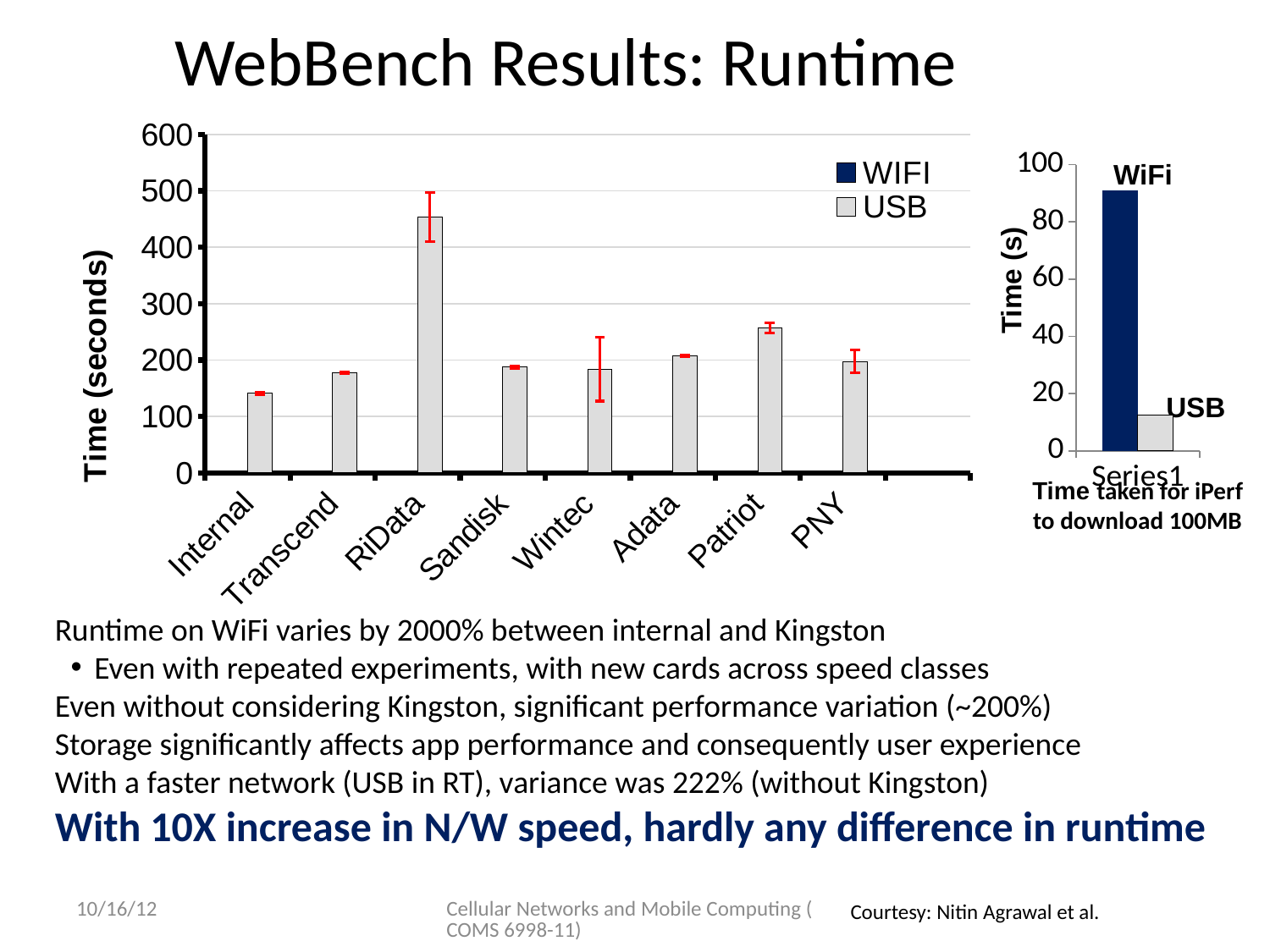
In the main WebBench runtime chart, which storage card has the highest USB runtime? RiData In the main WebBench runtime chart, is the value for Transcend greater or less than 200? less In the main WebBench runtime chart, which is larger, the value for Patriot or the value for Adata? Patriot What kind of chart is the main WebBench runtime chart? bar chart In the small chart on the right showing time taken for iPerf to download 100MB, is the value for WiFi greater or less than 80? greater In the small chart on the right showing time taken for iPerf to download 100MB, which is larger, WiFi or USB? WiFi In the main WebBench runtime chart, is the value for RiData greater or less than 400? greater How many series does the legend of the main WebBench runtime chart list? 2 In the main WebBench runtime chart, which category has the lowest runtime? Internal How many storage card categories are shown on the x axis of the main WebBench runtime chart? 8